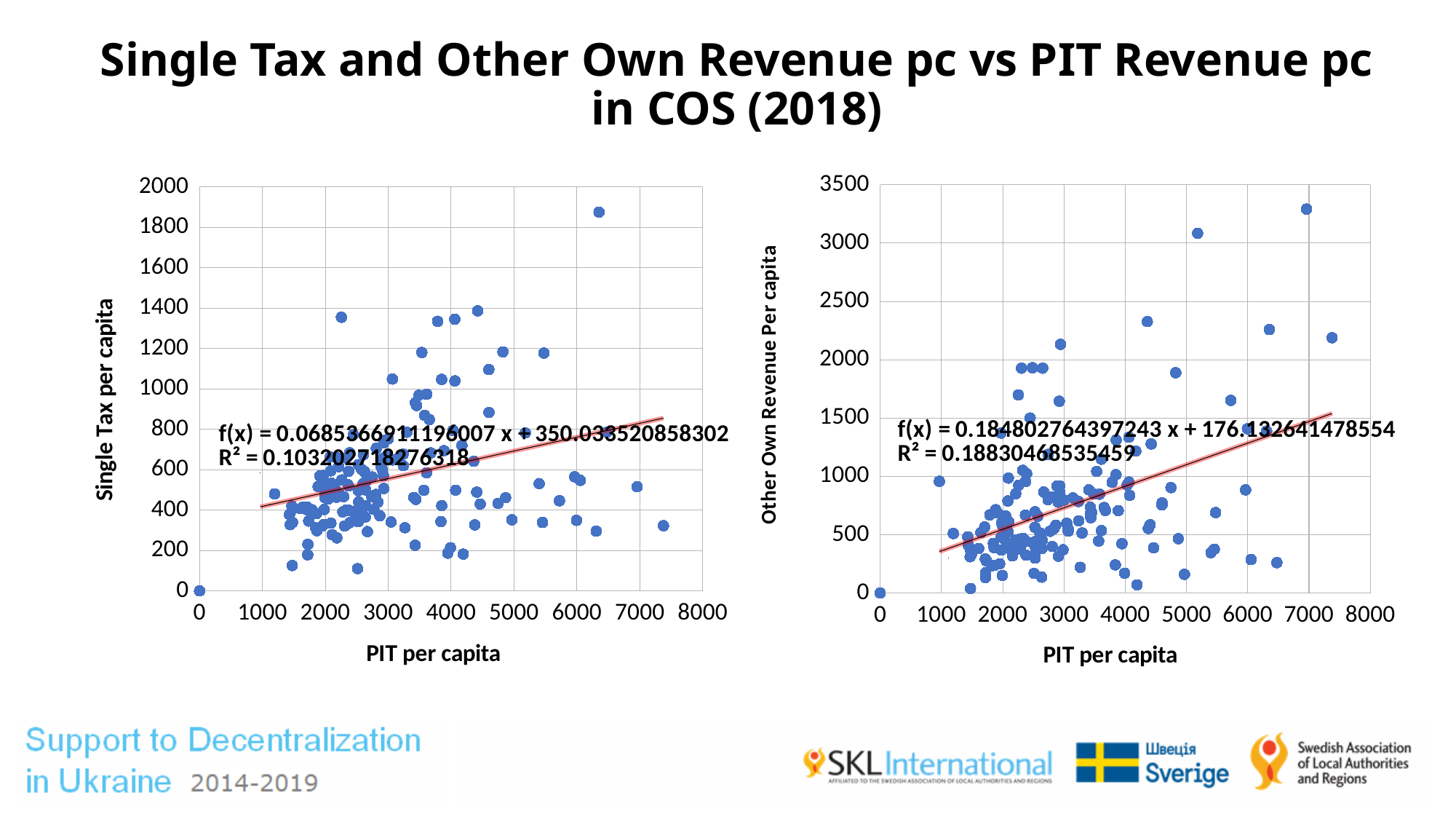
What kind of chart is the right chart, Other Own Revenue Per capita vs PIT per capita? Scatter chart On the left chart, does the trendline rise or fall as PIT per capita increases? Rise On the left chart, is the highest Single Tax per capita value greater or less than 1800? greater Which chart has the higher R² value, the left chart (Single Tax) or the right chart (Other Own Revenue)? The right chart (Other Own Revenue) On the right chart, is the highest Other Own Revenue Per capita value greater or less than 3000? greater On the left chart, what is the R² value shown for the trendline? 0.103202718276318 On the right chart, what is the trendline equation shown? f(x) = 0.184802764397243 x + 176.132641478554 On the right chart, does the trendline rise or fall as PIT per capita increases? Rise What is the label of the vertical axis on the right chart? Other Own Revenue Per capita On the left chart, what is the trendline equation shown? f(x) = 0.0685366911196007 x + 350.033520858302 What kind of chart is the left chart, Single Tax per capita vs PIT per capita? Scatter chart On the right chart, what is the R² value shown for the trendline? 0.18830468535459